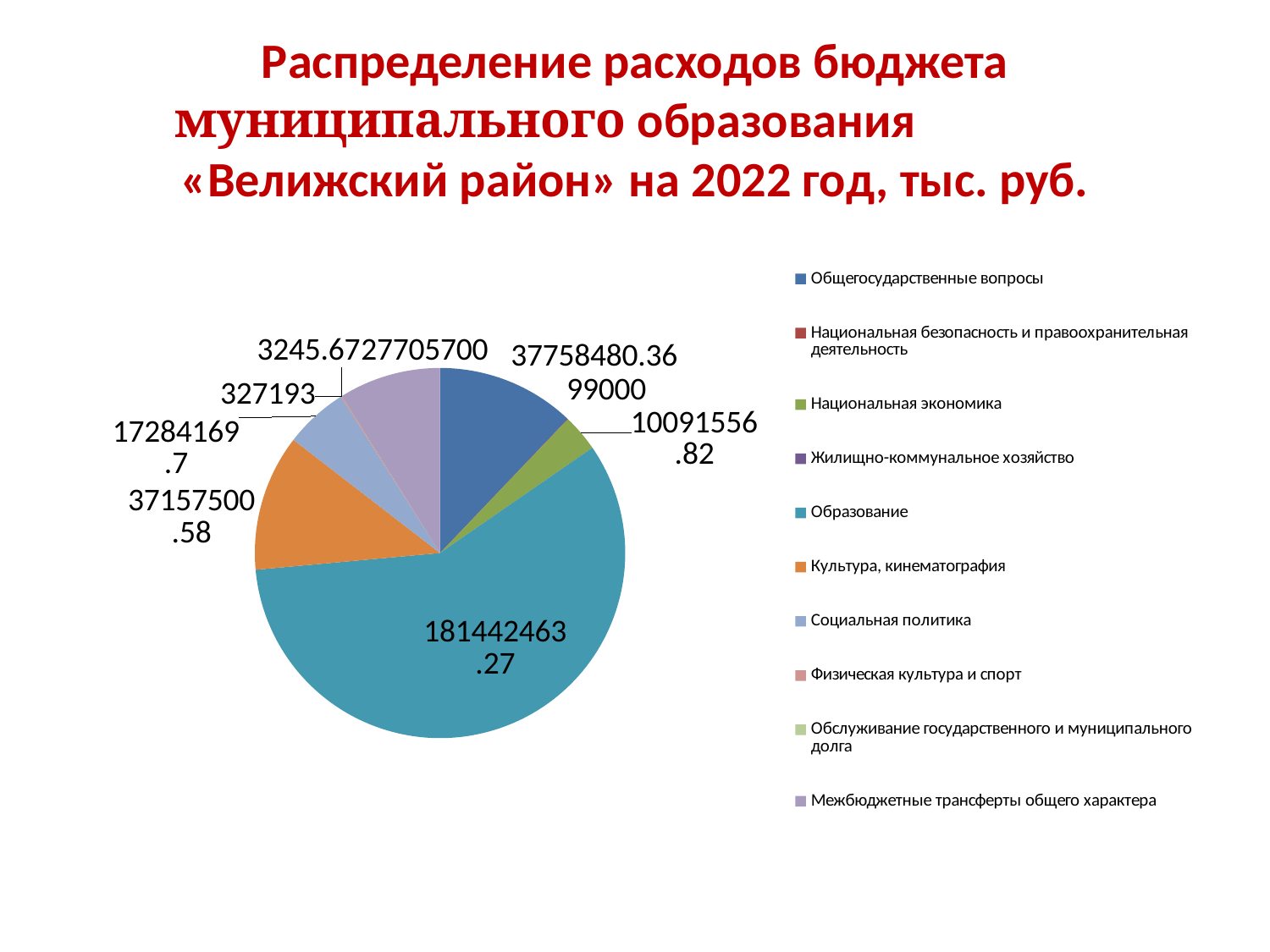
Which category has the largest slice of the pie? Образование How many categories does the legend list? 10 What is the value shown for Образование? 181442463.27 What is the value shown for Общегосударственные вопросы? 37758480.36 What is the difference between the values for Общегосударственные вопросы and Культура, кинематография? 600979.78 What is the value shown for Культура, кинематография? 37157500.58 What type of chart is shown on the slide? pie chart Which is larger, the value for Общегосударственные вопросы or the value for Культура, кинематография? Общегосударственные вопросы What is the value shown for Национальная экономика? 10091556.82 Which is larger, the value for Образование or the value for Социальная политика? Образование What colour is the slice for Образование? teal What is the value shown for Социальная политика? 17284169.7